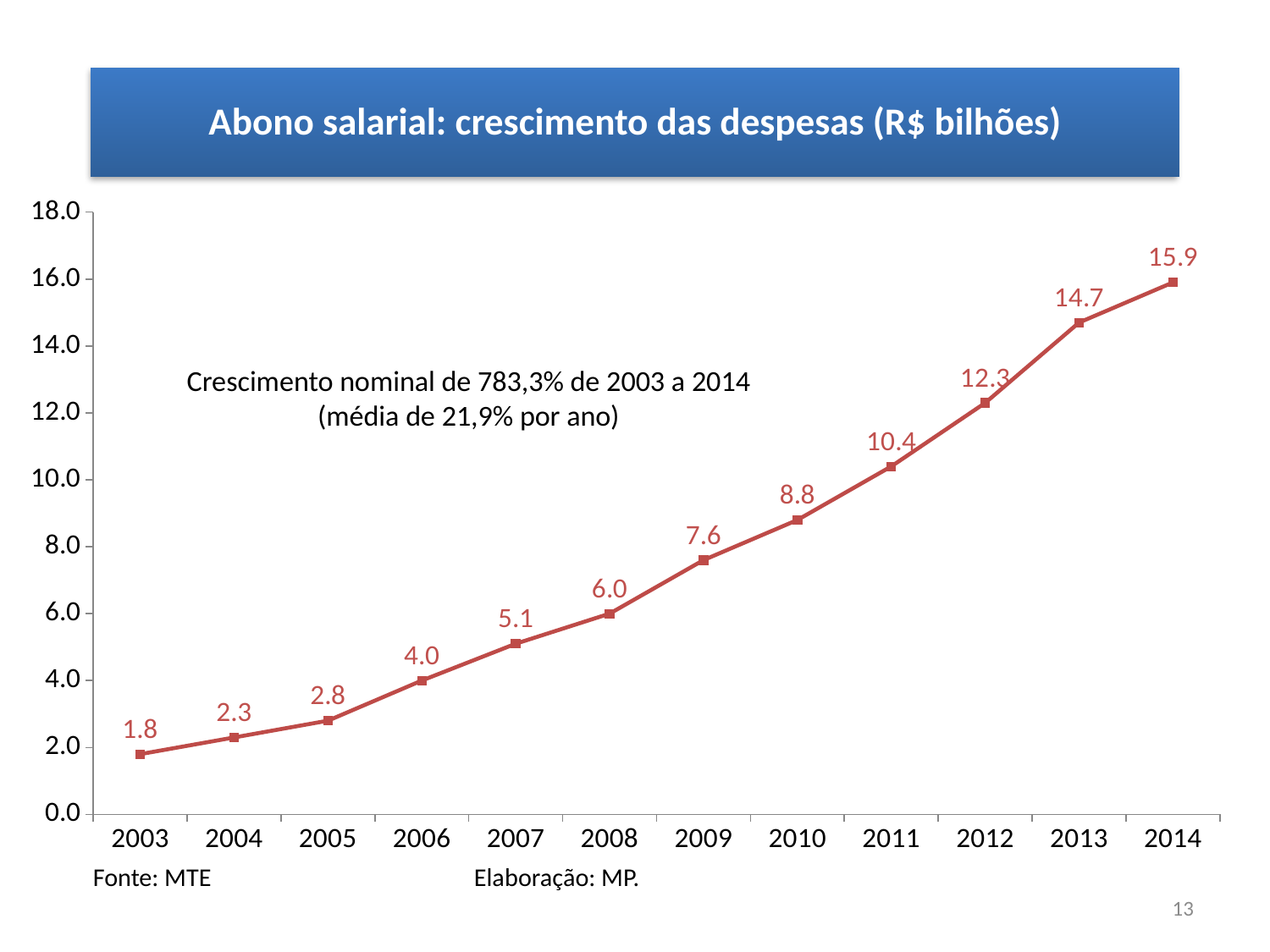
What is the value for 2011? 10.4 Do the values rise or fall from 2003 to 2014? rise Which is larger, the value for 2007 or the value for 2012? 2012 Which year has the lowest value? 2003 What kind of chart is shown on the slide? line chart What is the difference between the values for 2014 and 2013? 1.2 Which year has the highest value? 2014 What is the value for 2003? 1.8 Is the value for 2013 greater or less than 14.0? greater What is the difference between the values for 2010 and 2009? 1.2 What is the value for 2008? 6.0 How many years are plotted on the chart? 12